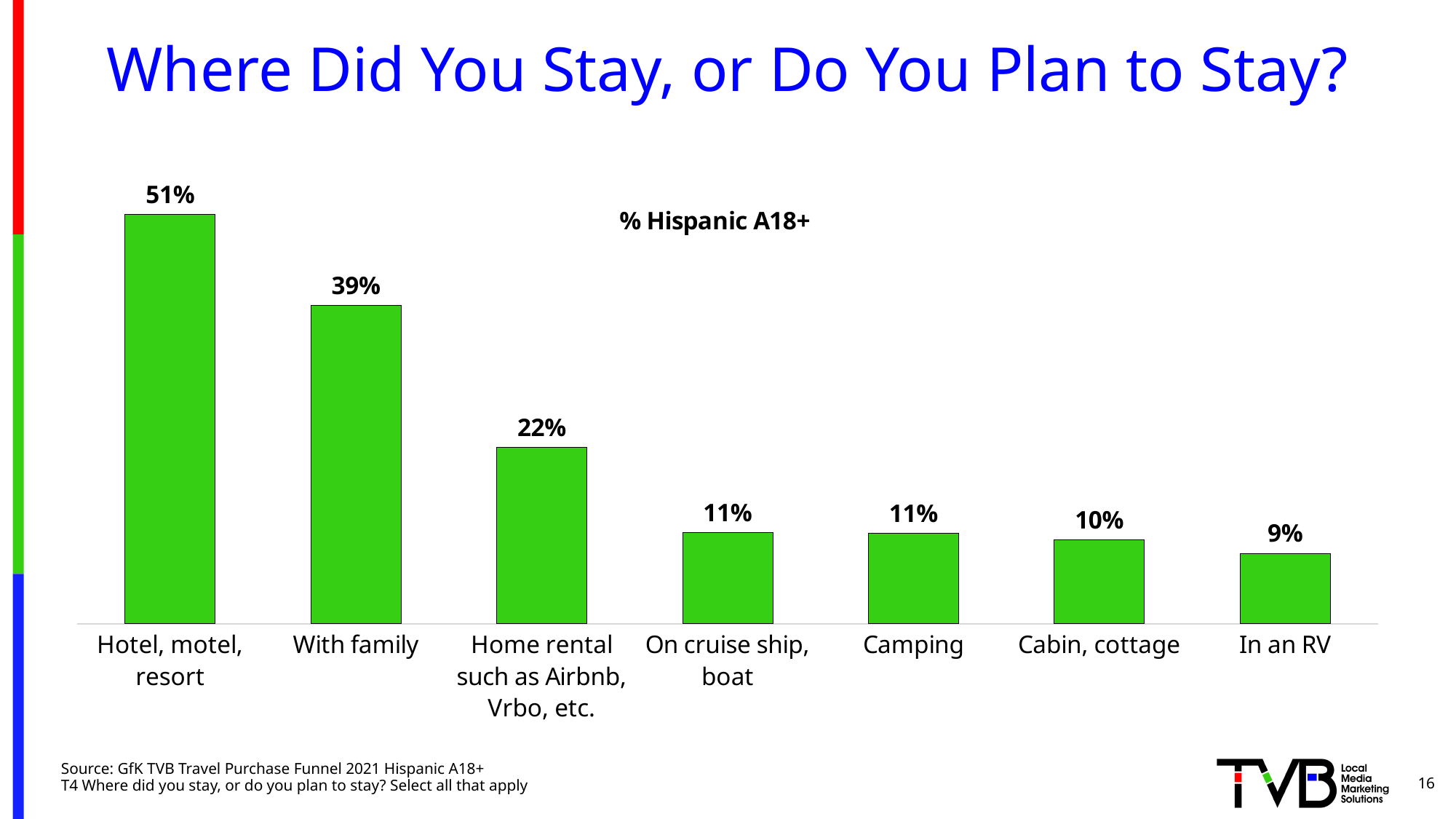
What is the difference between the values for 'Hotel, motel, resort' and 'With family'? 12% What is the value for 'In an RV'? 9% Which category has the highest value? Hotel, motel, resort What label appears above the chart describing the audience measured? % Hispanic A18+ How many categories are shown in the chart? 7 What is the value for 'With family'? 39% Which is larger, the value for 'Camping' or the value for 'In an RV'? Camping What percentage of Hispanic adults 18+ stayed or plan to stay at a hotel, motel, or resort? 51% Which category has the lowest value? In an RV What type of chart is shown on the slide? Bar chart What percentage is shown for 'Home rental such as Airbnb, Vrbo, etc.'? 22% What is the difference between 'With family' and 'Home rental such as Airbnb, Vrbo, etc.'? 17%